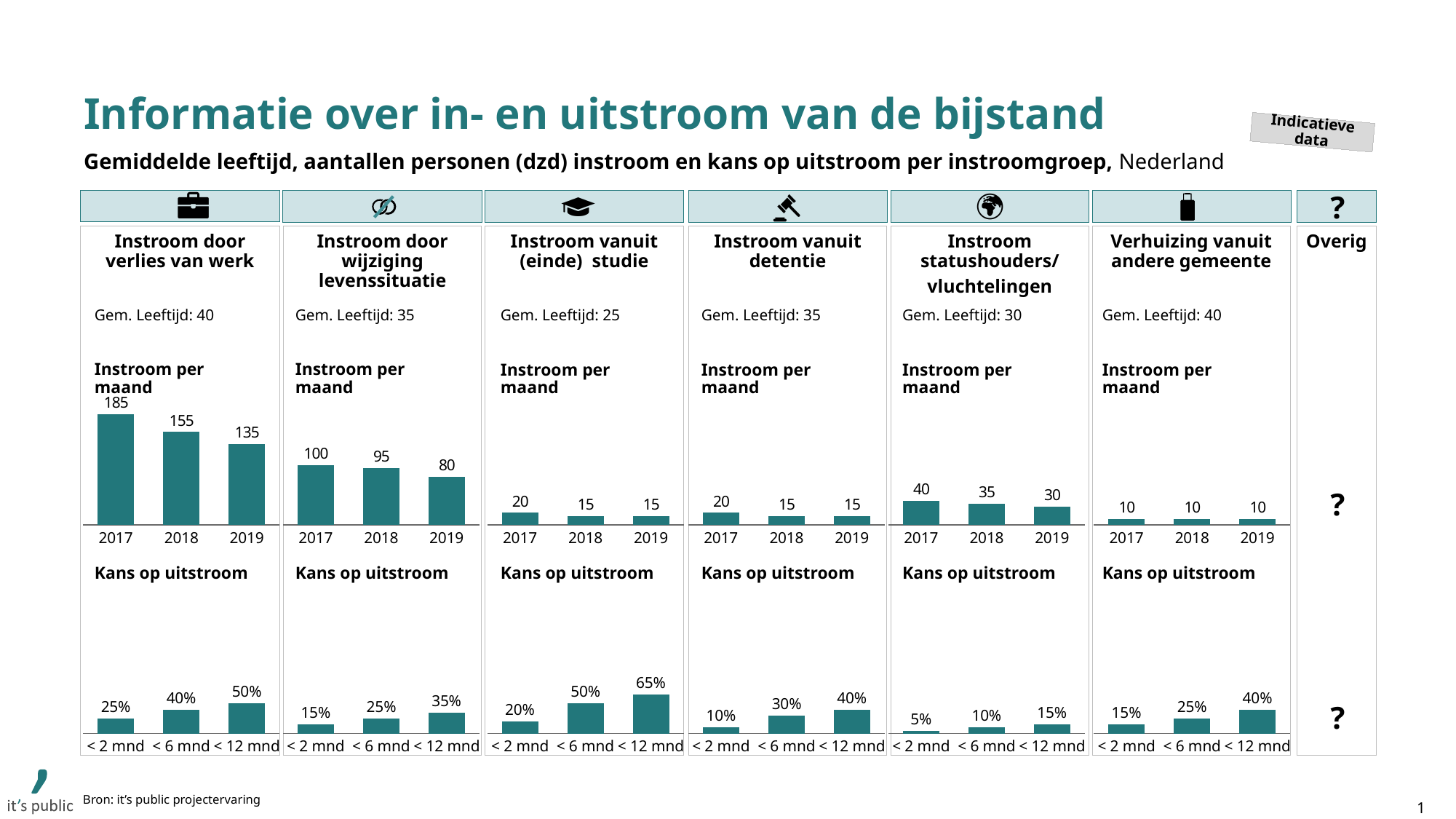
How many bars are in the 'Instroom per maand' chart for 'Verhuizing vanuit andere gemeente'? 3 In the 'Kans op uitstroom' chart for 'Instroom vanuit (einde) studie', what is the value for '< 12 mnd'? 65% What kind of chart is the 'Kans op uitstroom' chart for 'Instroom door verlies van werk'? bar chart In the 'Kans op uitstroom' chart for 'Instroom vanuit detentie', which category has the lowest value? < 2 mnd In the 'Instroom per maand' chart for 'Instroom door verlies van werk', which year has the highest value? 2017 In the 'Instroom per maand' chart for 'Instroom door wijziging levenssituatie', what is the value for 2019? 80 In the 'Instroom per maand' chart for 'Instroom statushouders/vluchtelingen', is the value for 2017 larger or smaller than the value for 2019? larger In the 'Instroom per maand' chart for 'Instroom door verlies van werk', what is the difference between the 2017 and 2019 values? 50 In the 'Instroom per maand' chart for 'Instroom door wijziging levenssituatie', do the values rise or fall from 2017 to 2019? fall In the 'Kans op uitstroom' chart for 'Instroom vanuit (einde) studie', what is the difference between the '< 6 mnd' and '< 2 mnd' values? 30% In the 'Instroom per maand' chart for 'Instroom door verlies van werk', what is the value for 2017? 185 In the 'Kans op uitstroom' chart for 'Instroom statushouders/vluchtelingen', what is the value for '< 2 mnd'? 5%